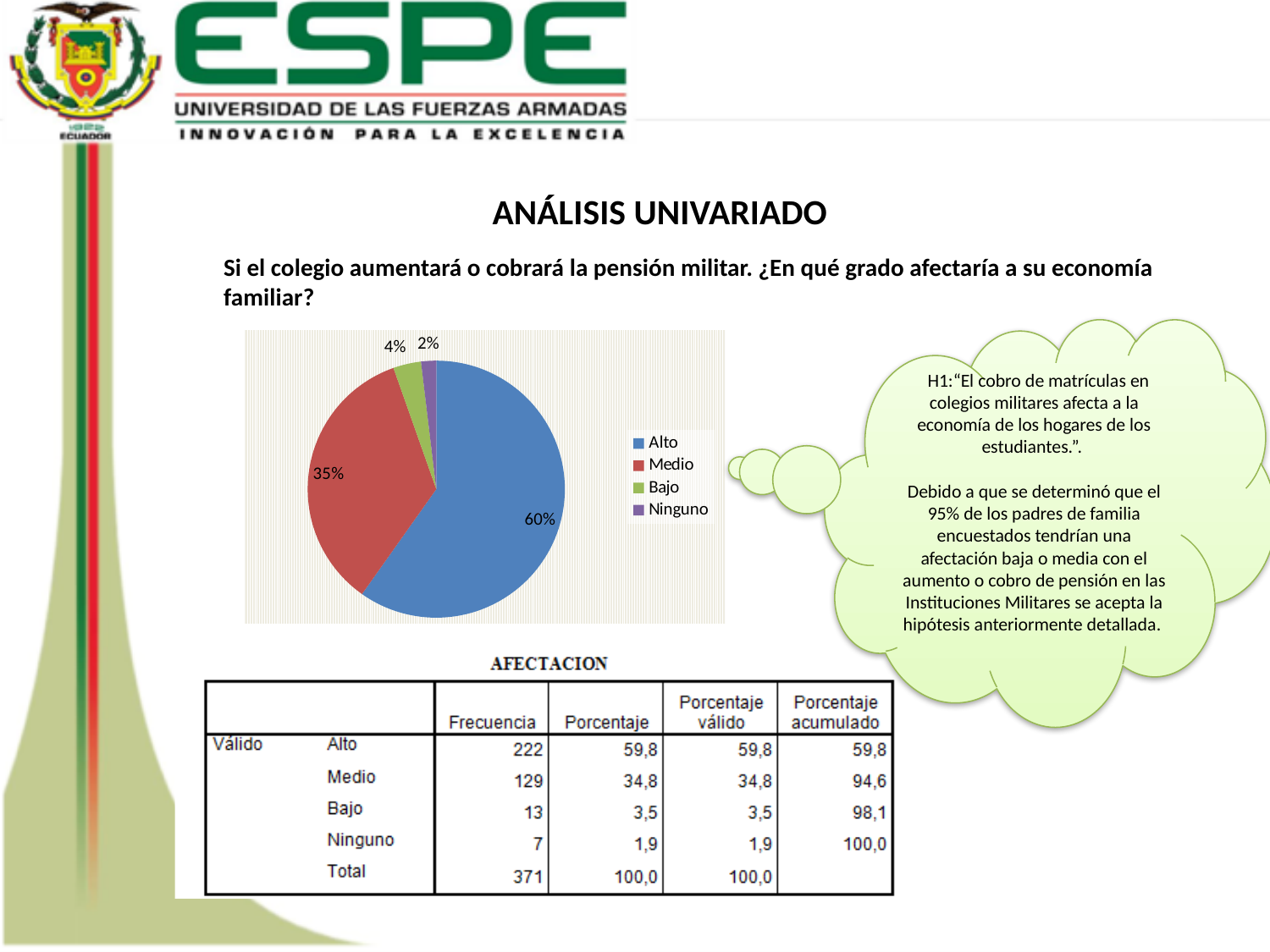
Which slice is larger, Bajo or Ninguno? Bajo What percentage of the pie chart is labelled Ninguno? 2% What percentage of the pie chart is labelled Bajo? 4% What is the difference in percentage points between the Alto and Medio slices? 25 What colour is the Medio slice in the pie chart? red How many categories does the legend of the pie chart list? 4 What colour is the Alto slice in the pie chart? blue Which category has the smallest slice in the pie chart? Ninguno What kind of chart is shown on the slide? pie chart What percentage of the pie chart is labelled Alto? 60% What percentage of the pie chart is labelled Medio? 35% Which category has the largest slice in the pie chart? Alto